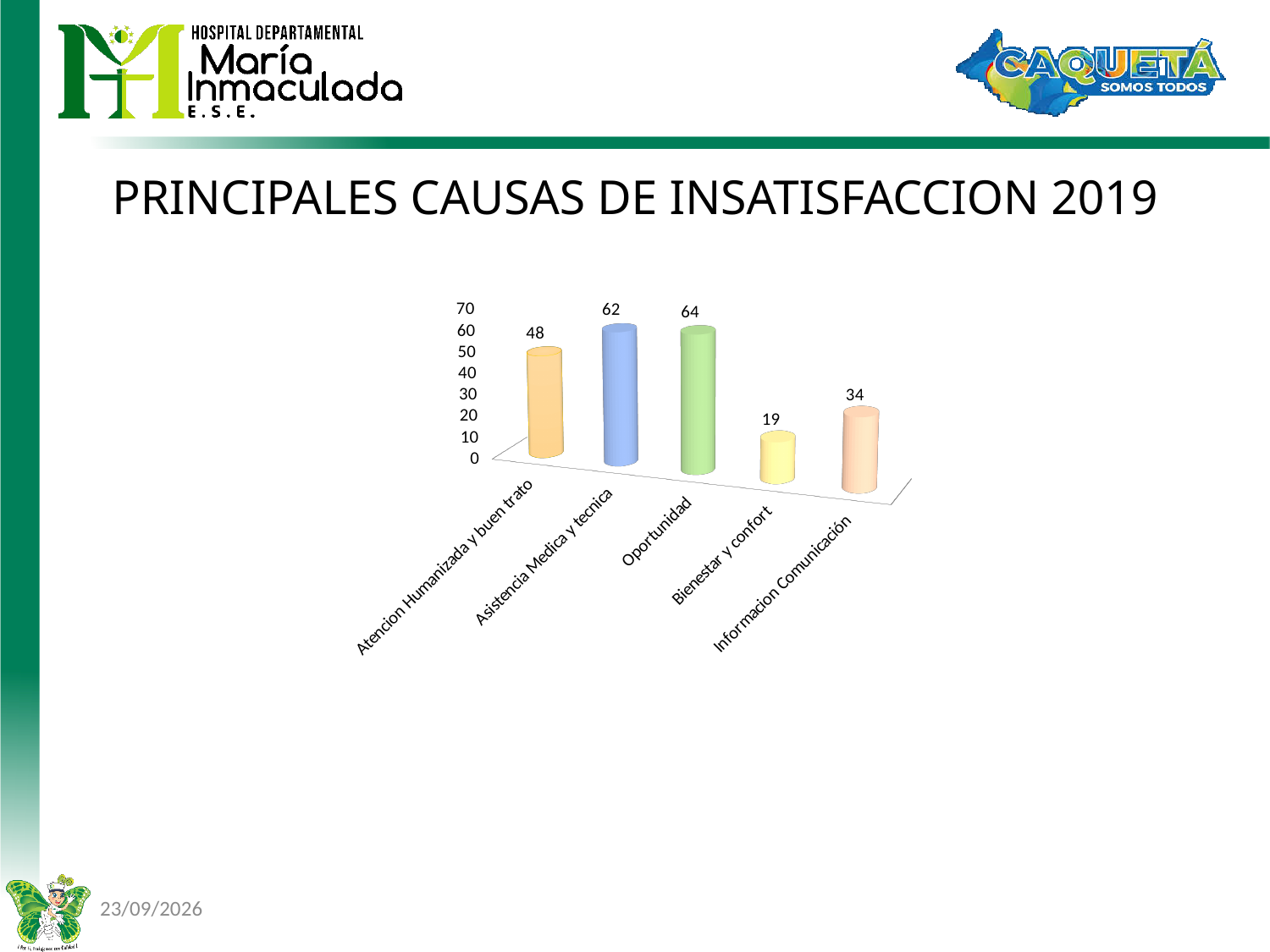
What is the value for Informacion Comunicación? 34 Which is larger, the value for Atencion Humanizada y buen trato or the value for Informacion Comunicación? Atencion Humanizada y buen trato What is the difference between the values for Asistencia Medica y tecnica and Bienestar y confort? 43 How many categories are shown in the chart? 5 What is the value for Bienestar y confort? 19 What is the value for Atencion Humanizada y buen trato? 48 Which category has the highest value? Oportunidad Is the value for Asistencia Medica y tecnica greater or less than 50? greater What is the title of the slide containing the chart? PRINCIPALES CAUSAS DE INSATISFACCION 2019 Which category has the lowest value? Bienestar y confort What kind of chart is shown on the slide? bar chart What is the value for Oportunidad? 64